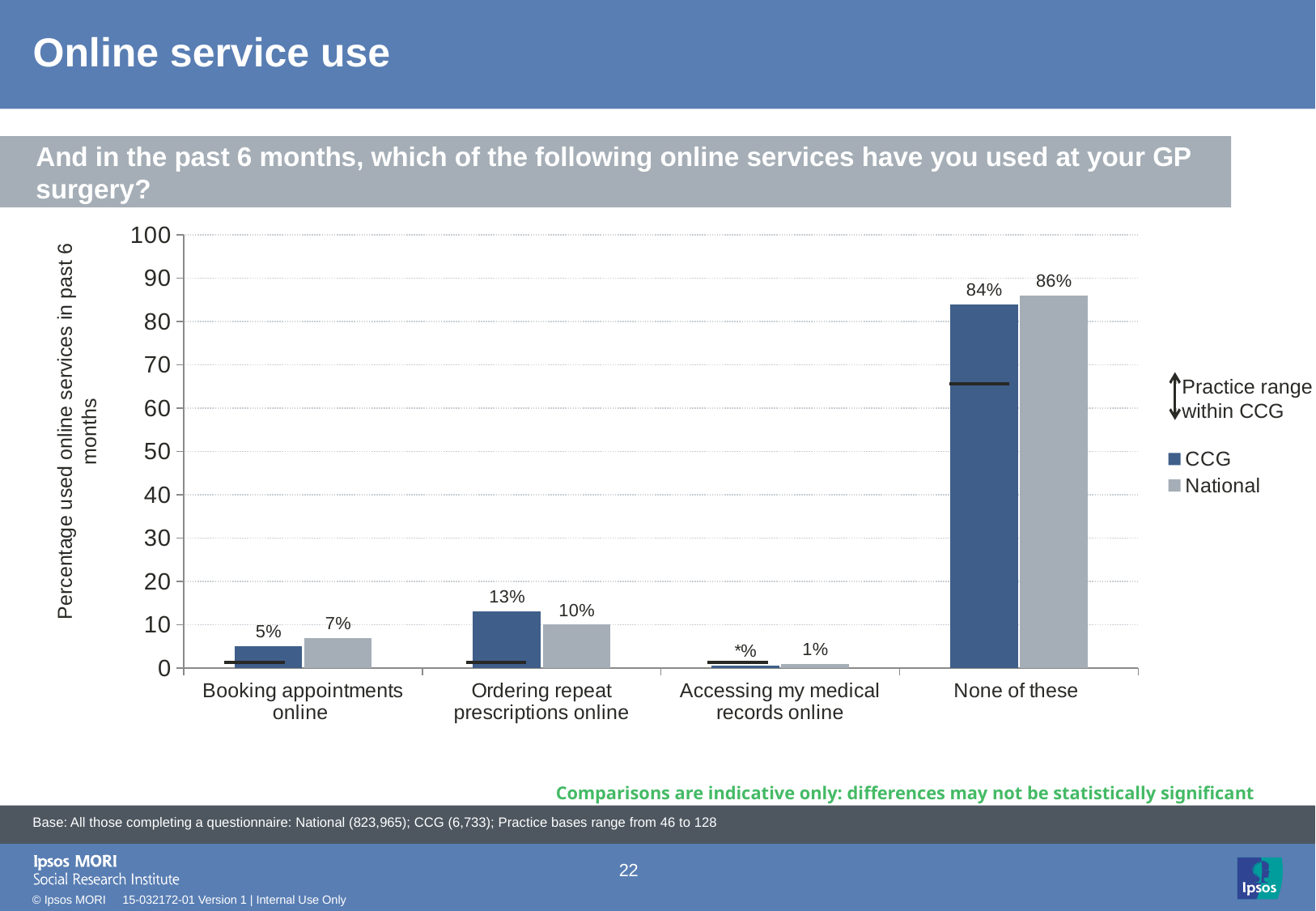
Which is larger for Ordering repeat prescriptions online, the CCG value or the National value? CCG Which category has the lowest National value? Accessing my medical records online What is the difference between the National and CCG values for None of these? 2% Is the CCG value for None of these greater or less than 80? greater Which category has the highest CCG value? None of these How many series does the legend list? 2 What is the National value for Ordering repeat prescriptions online? 10% How many categories are shown on the x axis? 4 What is the National value for None of these? 86% What is the CCG value for Ordering repeat prescriptions online? 13% What kind of chart is shown on the slide? Bar chart What is the CCG value for Booking appointments online? 5%